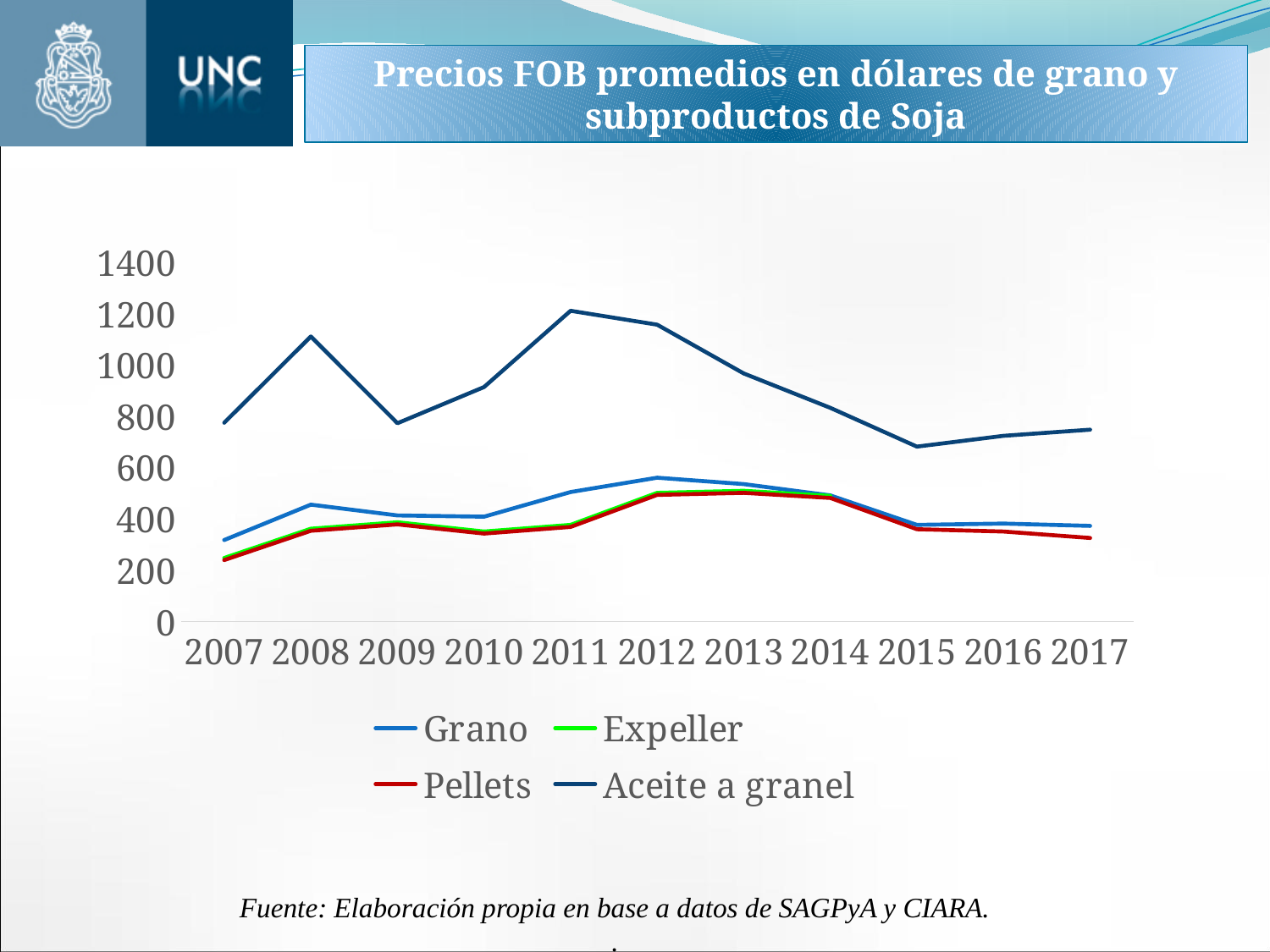
Is the value for Aceite a granel in 2015 greater or less than 800? less Which series has the higher value in 2009, Aceite a granel or Grano? Aceite a granel Is the value for Grano in 2012 greater or less than 400? greater What is the title of the chart? Precios FOB promedios en dólares de grano y subproductos de Soja How many years are shown on the x axis? 11 How many series does the legend list? 4 In which year does the Aceite a granel series reach its lowest value? 2015 What kind of chart is shown on the slide? line chart Is the value for Pellets in 2007 greater or less than 400? less In which year does the Aceite a granel series reach its highest value? 2011 Does the Aceite a granel series rise or fall between 2012 and 2015? fall